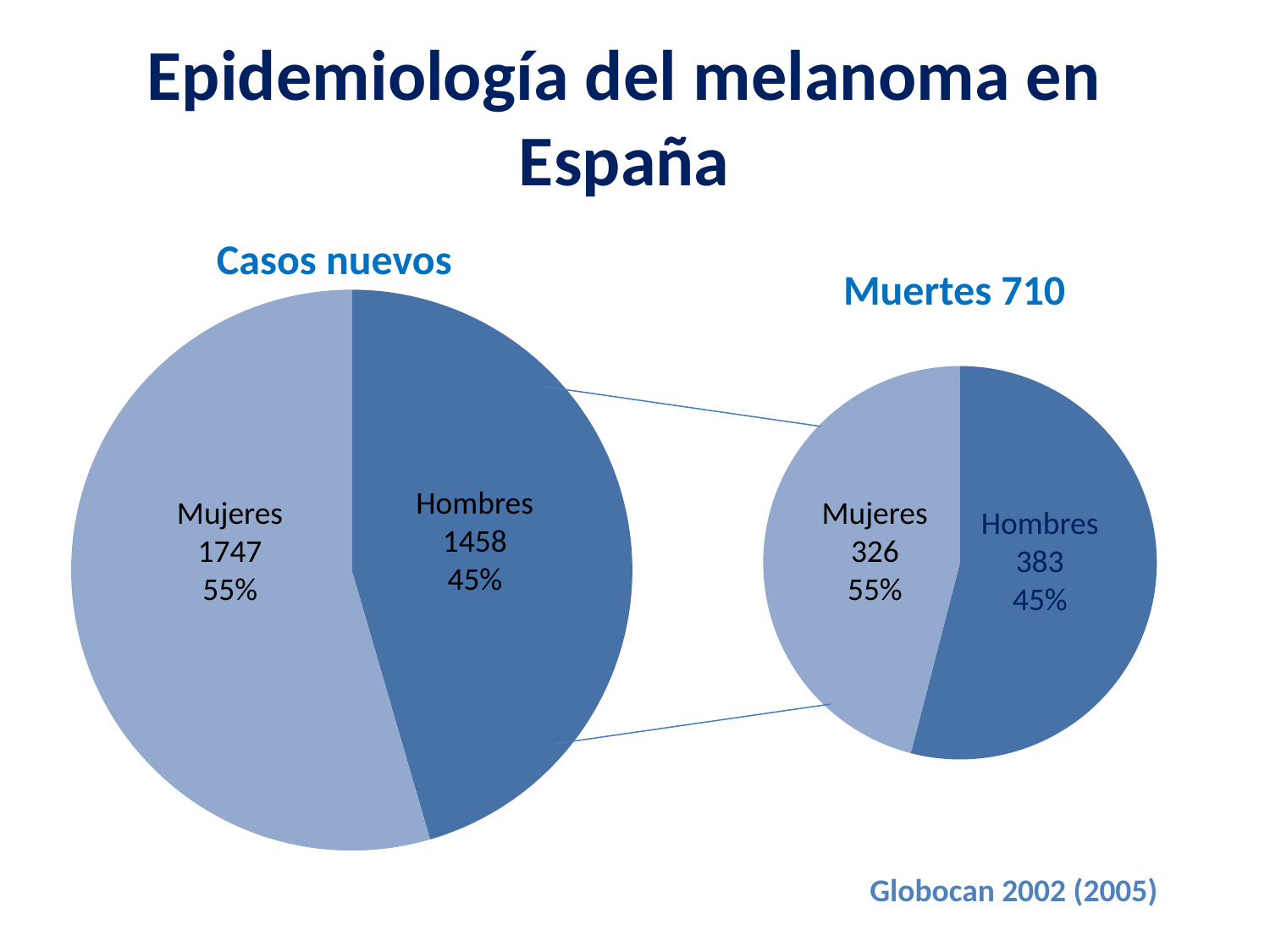
In the Muertes 710 chart, what is the value for Mujeres? 326 In the Muertes 710 chart, what is the difference between the Hombres and Mujeres values? 57 In the Casos nuevos chart, which category has the highest value? Mujeres In the Casos nuevos chart, what is the value for Mujeres? 1747 In the Casos nuevos chart, what share of the pie does Hombres represent? 45% In the Casos nuevos chart, what is the difference between the Mujeres and Hombres values? 289 In the Muertes 710 chart, what is the value for Hombres? 383 What is the title of the chart on the right of the slide? Muertes 710 How many categories does the Muertes 710 chart show? 2 What kind of chart is the Casos nuevos chart? Pie chart In the Casos nuevos chart, what share of the pie does Mujeres represent? 55% In the Casos nuevos chart, what is the value for Hombres? 1458